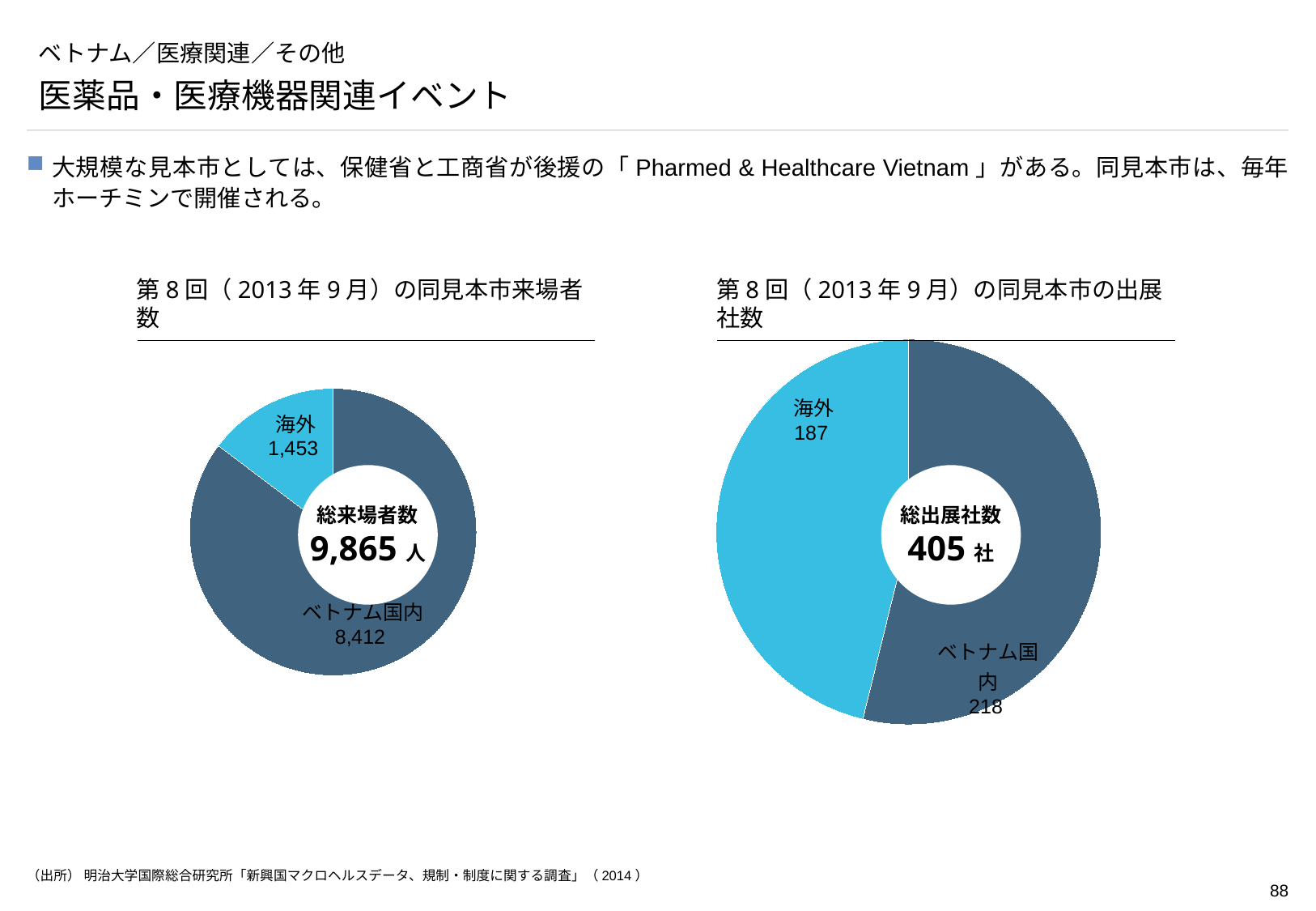
What type of chart is used for the 第8回の同見本市来場者数 on the left? Pie (donut) chart In the right chart (第8回の同見本市の出展社数), what is the total number of exhibitors shown in the centre? 405 社 In the right chart (第8回の同見本市の出展社数), which is larger, 海外 or ベトナム国内? ベトナム国内 In the left chart (第8回の同見本市来場者数), what is the difference between the ベトナム国内 and 海外 visitor counts? 6,959 In the right chart (第8回の同見本市の出展社数), how many exhibitors were from ベトナム国内? 218 In the right chart (第8回の同見本市の出展社数), what is the difference between the ベトナム国内 and 海外 exhibitor counts? 31 In the left chart (第8回の同見本市来場者数), what is the total number of visitors shown in the centre? 9,865 人 In the left chart (第8回の同見本市来場者数), how many visitors were from ベトナム国内? 8,412 In the left chart (第8回の同見本市来場者数), which segment is the largest? ベトナム国内 In the right chart (第8回の同見本市の出展社数), how many exhibitors were from 海外? 187 In the right chart (第8回の同見本市の出展社数), which segment is the smallest? 海外 In the left chart (第8回の同見本市来場者数), how many visitors came from 海外? 1,453